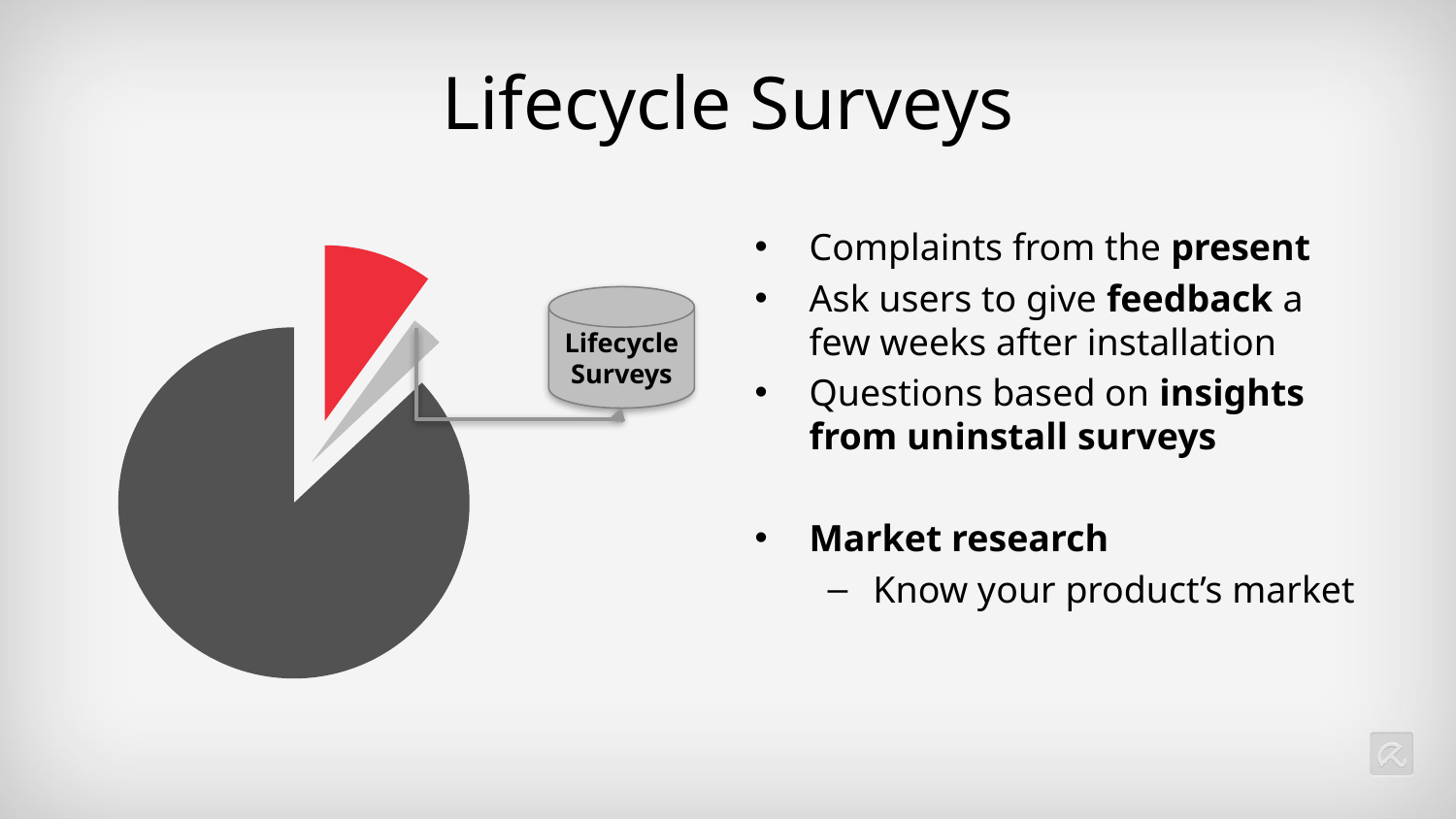
What colour is the exploded slice pulled furthest out of the pie chart? red What kind of chart is shown on the slide? pie chart Which slice of the pie chart is the largest? the dark grey slice What is the title of the slide containing the pie chart? Lifecycle Surveys Is the red slice larger or smaller than the dark grey slice? smaller